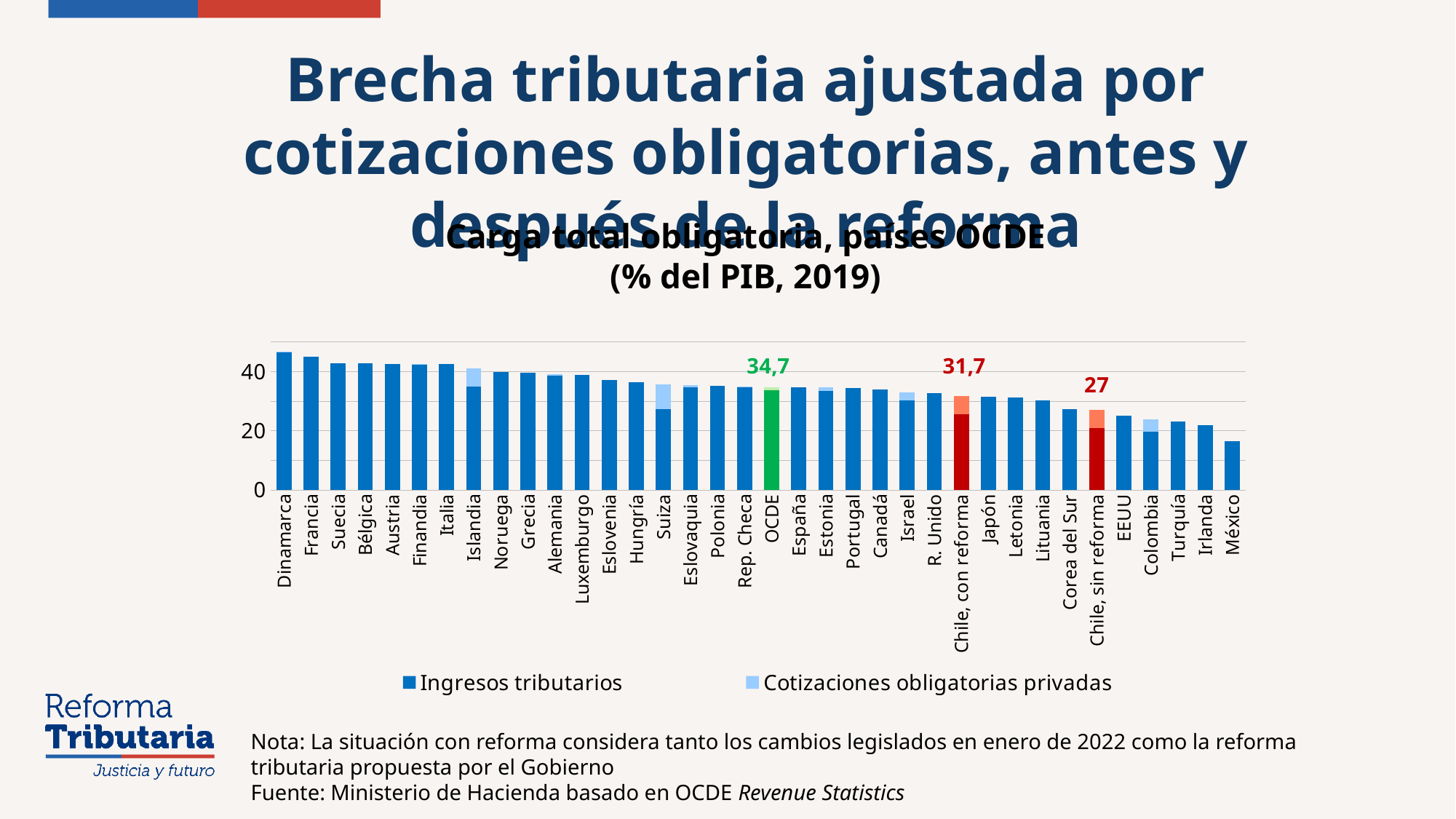
What is the labelled value for Chile, sin reforma? 27 Which country has the highest total bar? Dinamarca Do the bar totals generally rise or fall from left to right along the x axis? fall What is the difference between the labelled values for OCDE and Chile, con reforma? 3 Is the value for México greater or less than 20? less Which country has the lowest total bar? México What is the labelled value for OCDE? 34,7 Which is larger, the value for Chile, con reforma or Chile, sin reforma? Chile, con reforma How many series does the legend list? 2 What is the labelled value for Chile, con reforma? 31,7 Is the value for Dinamarca greater or less than 40? greater What is the difference between the labelled values for Chile, con reforma and Chile, sin reforma? 4,7